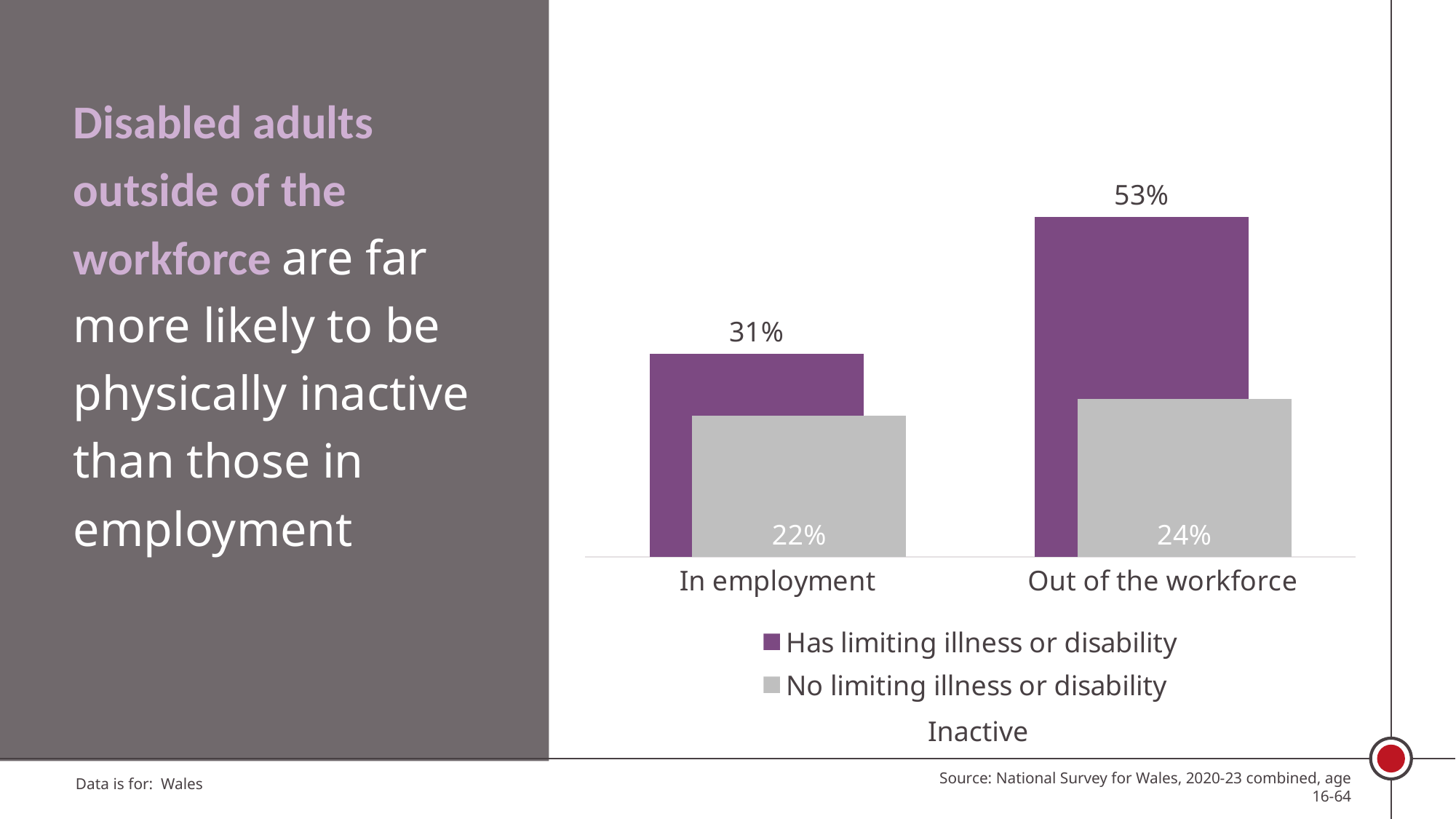
What percentage of people in employment with a limiting illness or disability are inactive? 31% What is the value for 'No limiting illness or disability' in the 'In employment' category? 22% What percentage of people out of the workforce with a limiting illness or disability are inactive? 53% What kind of chart is shown on the slide? Bar chart How many series does the legend list? 2 Which is larger: the 'Has limiting illness or disability' value for 'In employment' or the 'No limiting illness or disability' value for 'Out of the workforce'? Has limiting illness or disability, In employment In the 'Out of the workforce' category, what is the difference between the two series? 29 percentage points Which bar on the chart has the lowest value? No limiting illness or disability, In employment What is the difference between the 'Has limiting illness or disability' values for 'Out of the workforce' and 'In employment'? 22 percentage points How many categories are shown on the x axis? 2 Which category has the highest value for 'Has limiting illness or disability'? Out of the workforce What is the value for 'No limiting illness or disability' in the 'Out of the workforce' category? 24%